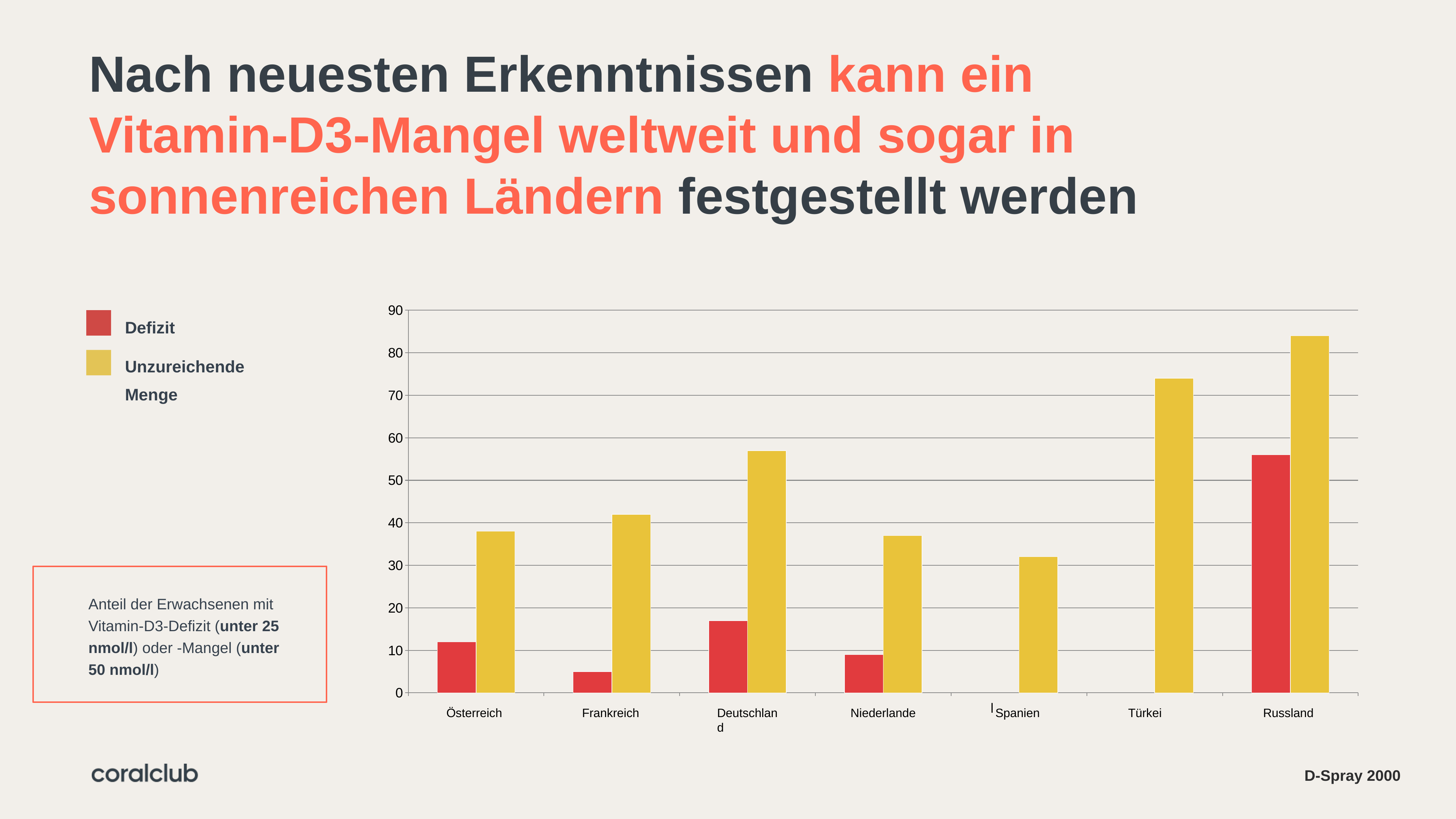
What colour represents the Defizit series in the chart? red Which country has the highest value for Unzureichende Menge? Russland Is the Unzureichende Menge value for Türkei greater or less than 70? greater Is the Defizit value for Frankreich greater or less than 10? less Which is larger, the Unzureichende Menge value for Deutschland or for Frankreich? Deutschland Is the Unzureichende Menge value for Russland greater or less than 80? greater How many countries are shown on the x axis of the chart? 7 Which country has the highest Defizit value? Russland Which country has the lowest value for Unzureichende Menge? Spanien How many series does the legend list? 2 What kind of chart is shown on the slide? bar chart